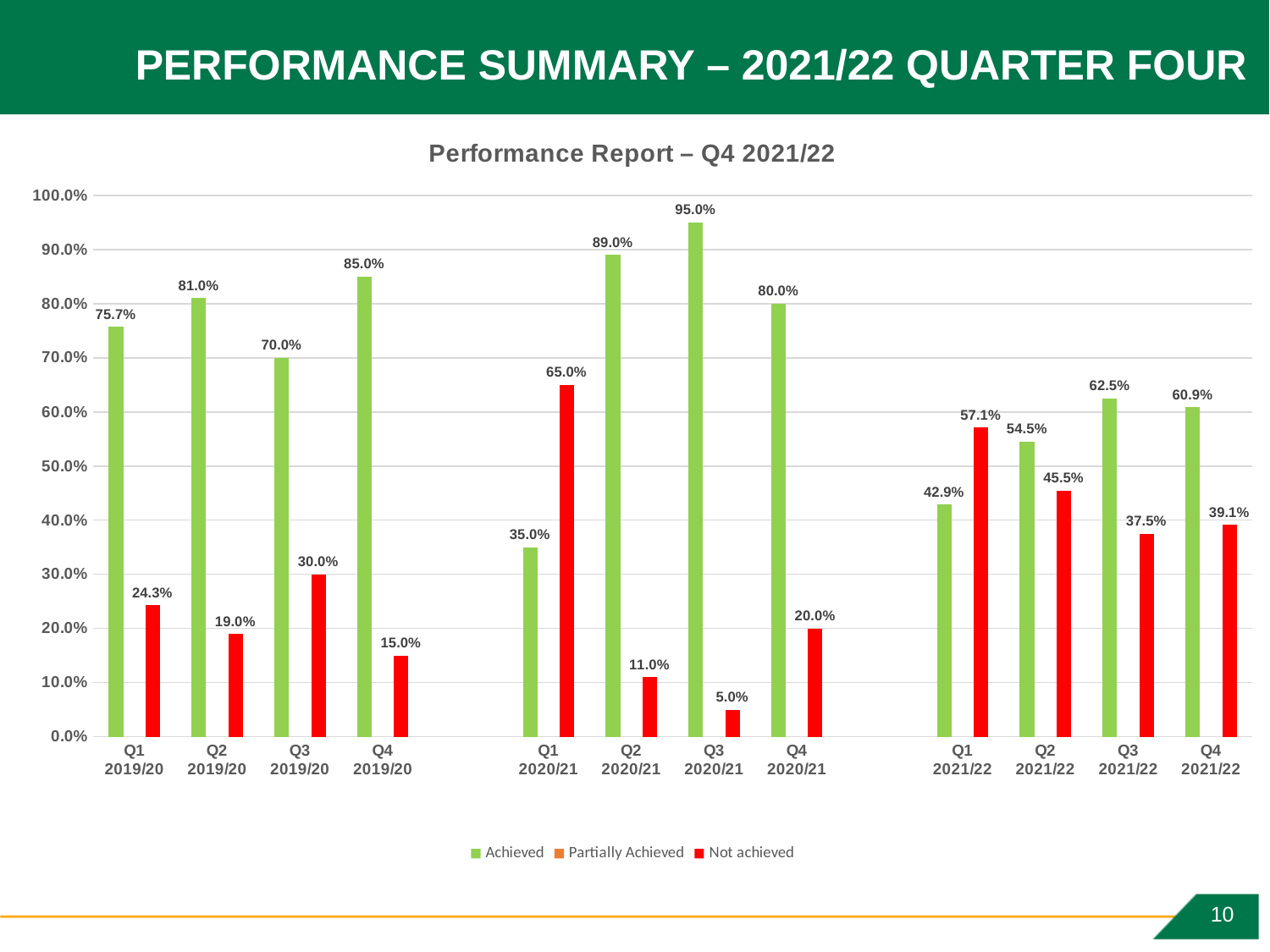
Which quarter has the lowest Not achieved value? Q3 2020/21 How many quarters are shown on the x axis? 12 What is the difference between the Achieved values for Q4 2019/20 and Q4 2021/22? 24.1% What is the Not achieved value for Q1 2021/22? 57.1% Which quarter has the highest Achieved value? Q3 2020/21 What is the title of the chart? Performance Report – Q4 2021/22 What is the Achieved value for Q3 2020/21? 95.0% Which is larger: the Achieved value for Q2 2021/22 or the Not achieved value for Q2 2021/22? Achieved (54.5%) What kind of chart is shown on the slide? Bar chart How many series does the legend list? 3 What is the Achieved value for Q4 2021/22? 60.9% Which quarter has the lowest Achieved value? Q1 2020/21